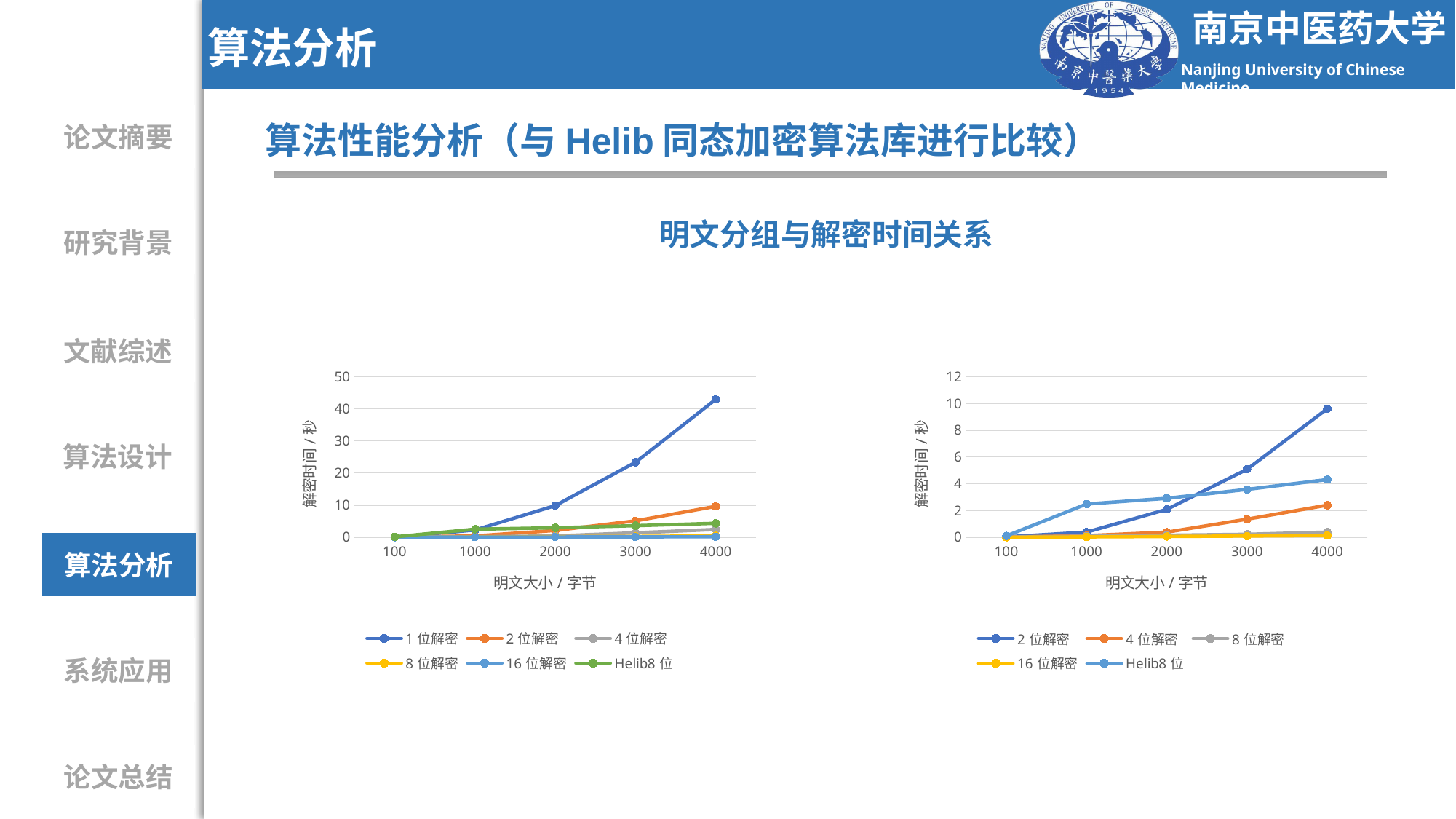
In the left chart, which series has the highest value at 4000 bytes? 1 位解密 How many series does the legend of the right chart list? 5 In the left chart, is the value for 1 位解密 at 3000 bytes greater or less than 20? greater In the right chart, which series has the highest value at 4000 bytes? 2 位解密 In the right chart, is the value for 2 位解密 at 4000 bytes greater or less than 8? greater What is the shared title above the two charts? 明文分组与解密时间关系 In the right chart, does the 2 位解密 series rise or fall as plaintext size increases from 100 to 4000 bytes? rise In the right chart, at 2000 bytes, which is larger: Helib8 位 or 2 位解密? Helib8 位 In the left chart, is the value for 1 位解密 at 4000 bytes greater or less than 40? greater How many plaintext-size points are shown on the x axis of the left chart? 5 What kind of chart is the left chart on the slide? line chart How many series does the legend of the left chart list? 6